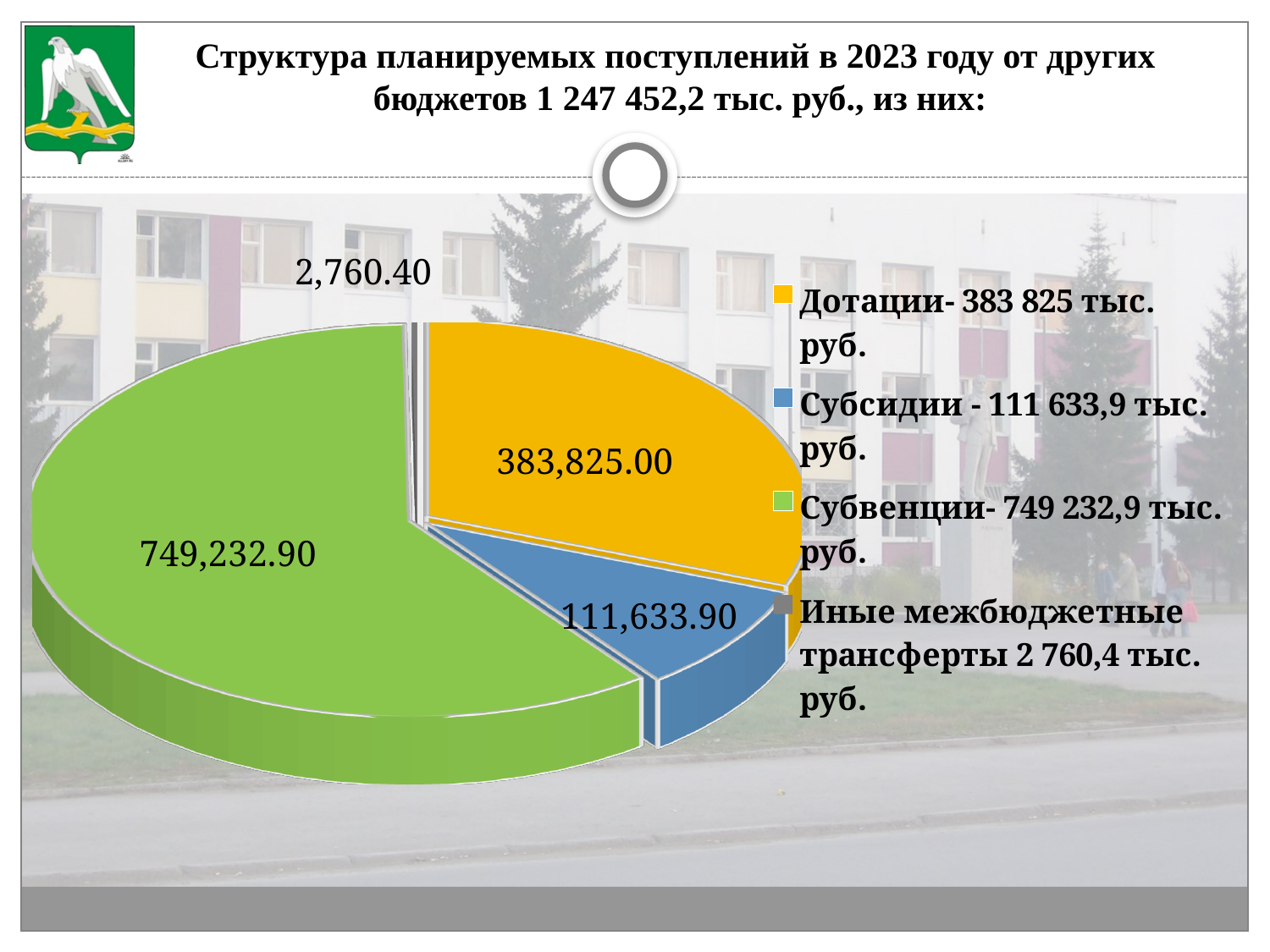
What is the value of the Субвенции slice in the pie chart? 749,232.90 What is the value of the Субсидии slice in the pie chart? 111,633.90 Which is larger in the pie chart, Дотации or Субсидии? Дотации What is the value of the Дотации slice in the pie chart? 383,825.00 Which category has the smallest slice in the pie chart? Иные межбюджетные трансферты What is the difference between the Субвенции and Дотации values in the pie chart? 365,407.90 What is the difference between the Дотации and Субсидии values in the pie chart? 272,191.10 What is the value of the Иные межбюджетные трансферты slice in the pie chart? 2,760.40 How many slices does the pie chart have? 4 Which category has the largest slice in the pie chart? Субвенции What type of chart is shown on the slide? Pie chart What colour is the Субвенции slice in the pie chart? Green